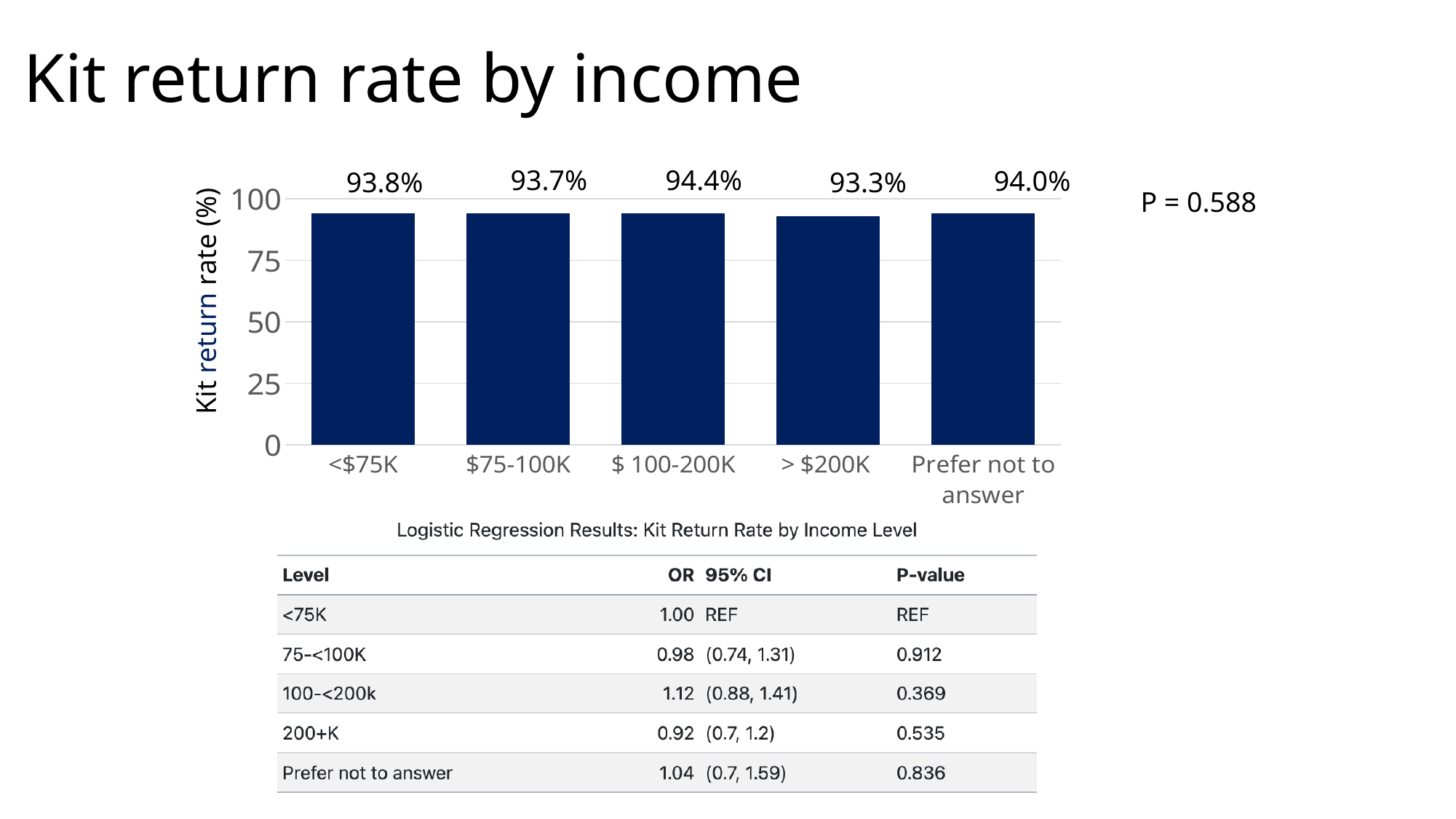
What is the kit return rate for the $ 100-200K income group? 94.4% Which income group has the lowest kit return rate? > $200K Which income group has the highest kit return rate? $ 100-200K What is the kit return rate for the > $200K income group? 93.3% What is the difference in kit return rate between the $ 100-200K group and the > $200K group? 1.1% Which has a higher kit return rate, the $75-100K group or the 'Prefer not to answer' group? Prefer not to answer What is the kit return rate for the 'Prefer not to answer' group? 94.0% What is the P value shown next to the chart? P = 0.588 Is the kit return rate for the $75-100K group greater or less than 75? greater What type of chart is used to show kit return rate by income? Bar chart How many income categories are shown in the chart? 5 What is the kit return rate for the <$75K income group? 93.8%